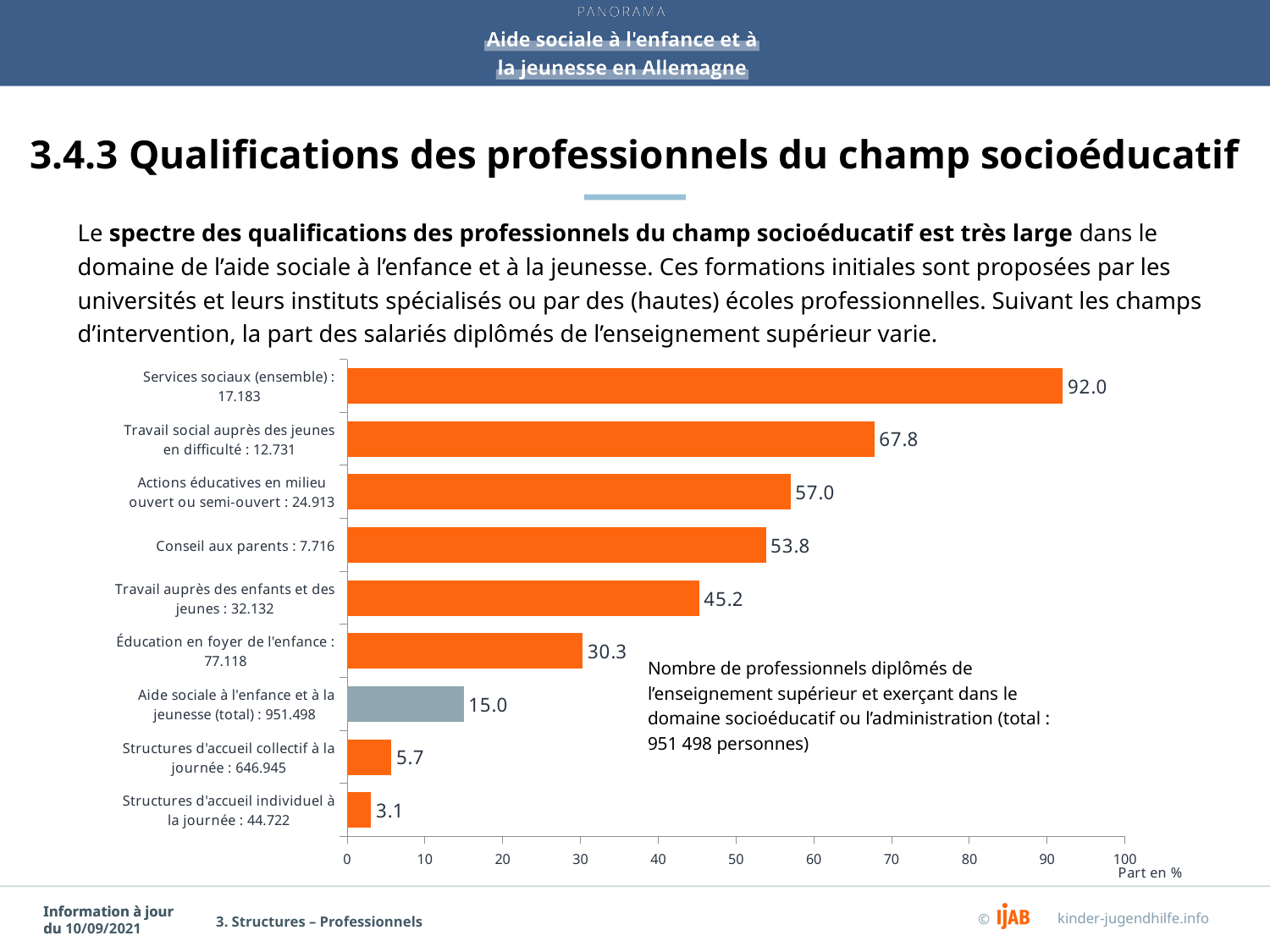
How many categories are shown in the chart? 9 Which is larger: the value for "Éducation en foyer de l'enfance : 77.118" or the value for "Travail auprès des enfants et des jeunes : 32.132"? Travail auprès des enfants et des jeunes : 32.132 What is the difference between the values for "Travail social auprès des jeunes en difficulté : 12.731" and "Actions éducatives en milieu ouvert ou semi-ouvert : 24.913"? 10.8 Is the value for "Structures d'accueil collectif à la journée : 646.945" greater or less than 10? less What is the label of the horizontal axis? Part en % Which bar is coloured grey instead of orange? Aide sociale à l'enfance et à la jeunesse (total) : 951.498 What is the value for "Services sociaux (ensemble) : 17.183"? 92.0 Which category has the lowest value? Structures d'accueil individuel à la journée : 44.722 What is the value for "Conseil aux parents : 7.716"? 53.8 What is the value for "Aide sociale à l'enfance et à la jeunesse (total) : 951.498"? 15.0 What kind of chart is shown on the slide? bar chart Which category has the highest value? Services sociaux (ensemble) : 17.183